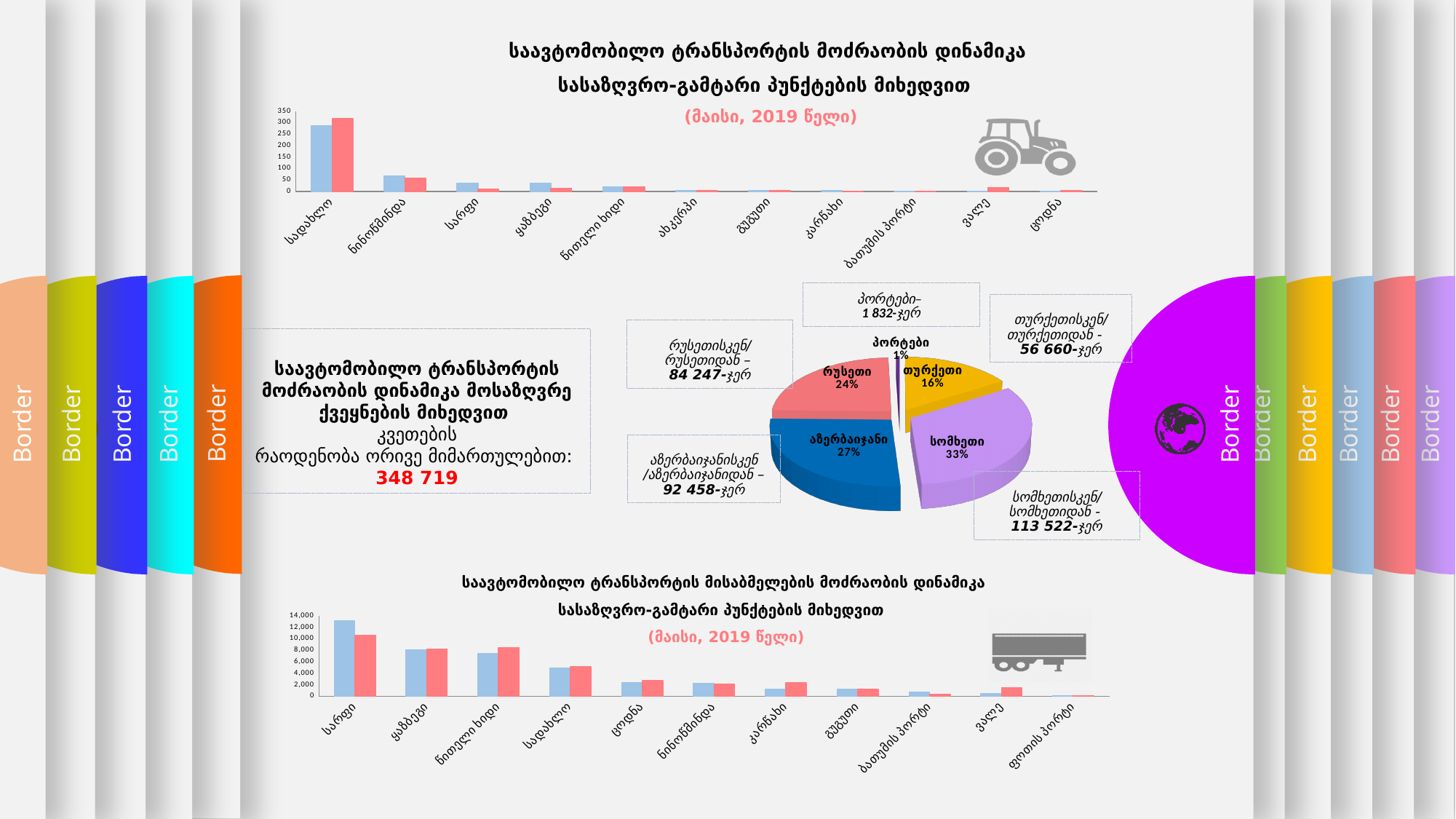
In the top bar chart, is the blue bar for სადახლო greater or less than 250? greater In the pie chart, which slice is the largest? სომხეთი In the pie chart, which is larger, the share for რუსეთი or the share for თურქეთი? რუსეთი In the pie chart, what is the difference in percentage points between the სომხეთი slice and the აზერბაიჯანი slice? 6 In the bottom bar chart, is the blue bar for სარფი greater or less than 12,000? greater What kind of chart is the chart at the top of the slide? bar chart In the pie chart, what share does სომხეთი have? 33% In the pie chart, which slice is the smallest? პორტები In the pie chart, what share does აზერბაიჯანი have? 27% In the top bar chart, which category has the tallest bars? სადახლო In the pie chart, how many slices are there? 5 According to the callout next to the pie chart, how many times (ჯერ) is given for სომხეთისკენ/სომხეთიდან? 113 522